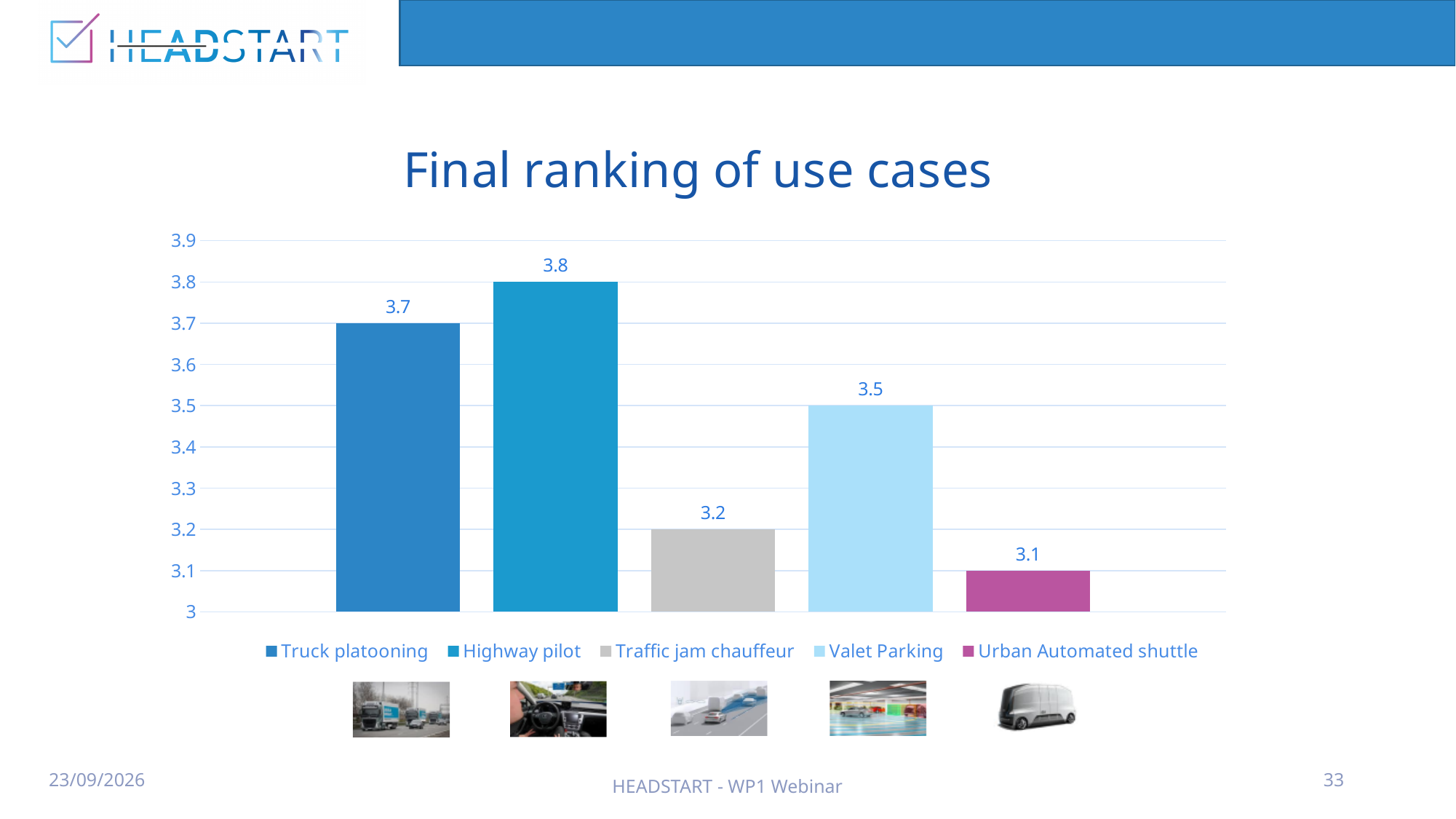
What kind of chart is shown on the slide? bar chart What is the difference between the values for Truck platooning and Urban Automated shuttle? 0.6 Which use case has the lowest value? Urban Automated shuttle What is the title of the chart? Final ranking of use cases How many use cases are shown in the chart? 5 Which is larger, the value for Valet Parking or the value for Traffic jam chauffeur? Valet Parking What is the value for Traffic jam chauffeur? 3.2 Is the value for Truck platooning greater or less than 3.5? greater What is the value for Urban Automated shuttle? 3.1 Which use case has the highest value? Highway pilot What is the difference between the values for Highway pilot and Valet Parking? 0.3 What is the value for Highway pilot? 3.8